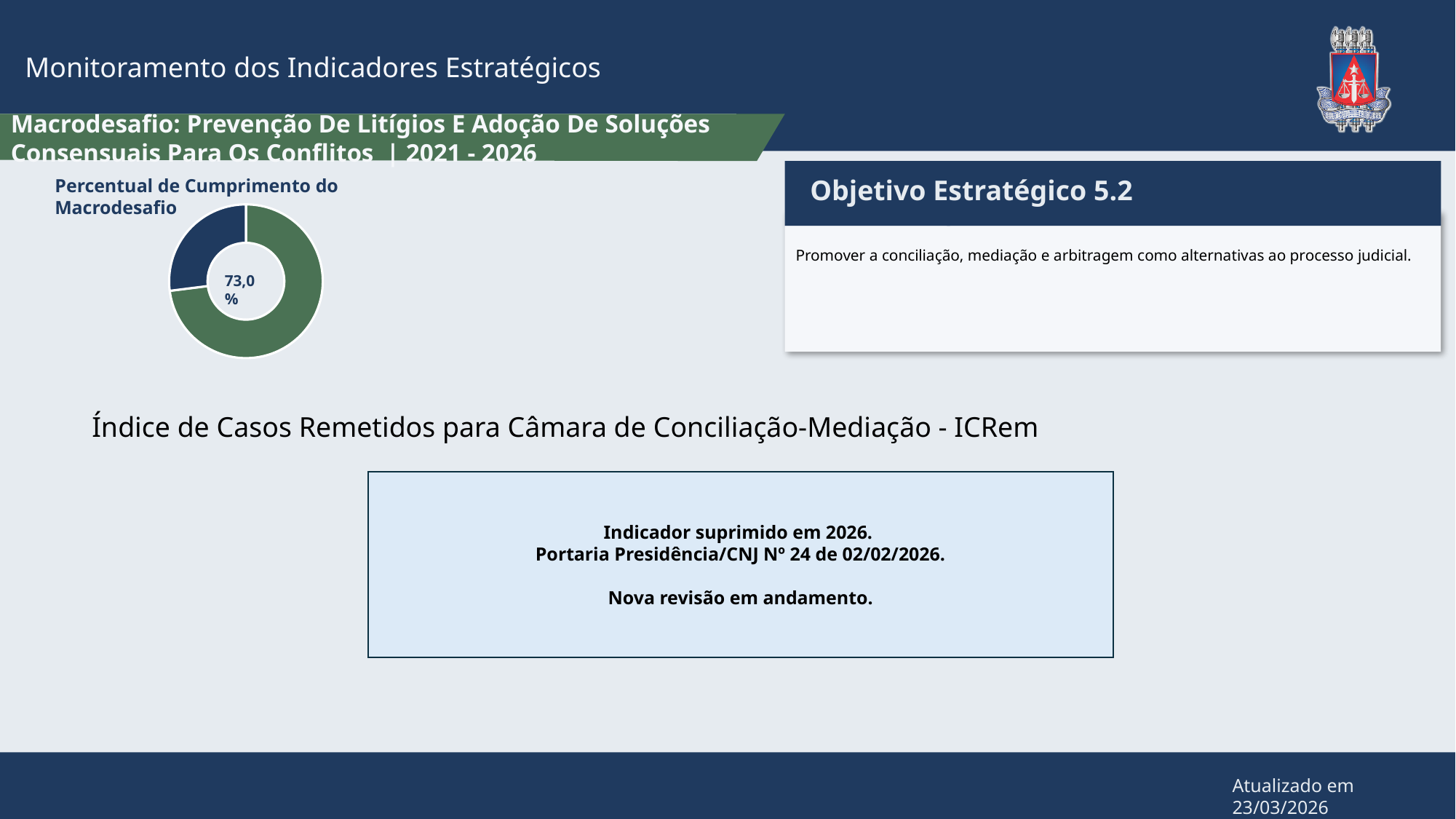
What value is printed in the centre of the "Percentual de Cumprimento do Macrodesafio" chart? 73,0% What two colours are used for the slices of the "Percentual de Cumprimento do Macrodesafio" chart? green and dark blue In the "Percentual de Cumprimento do Macrodesafio" chart, which slice is larger, the green one or the dark blue one? the green one Which colour slice is the largest in the "Percentual de Cumprimento do Macrodesafio" chart? green Is the percentage shown in the "Percentual de Cumprimento do Macrodesafio" chart greater or less than 50%? greater What is the title of the donut chart on the slide? Percentual de Cumprimento do Macrodesafio How many slices does the "Percentual de Cumprimento do Macrodesafio" donut chart have? 2 What kind of chart is shown under the title "Percentual de Cumprimento do Macrodesafio"? donut chart What share of the "Percentual de Cumprimento do Macrodesafio" donut does the green slice represent? 73,0%